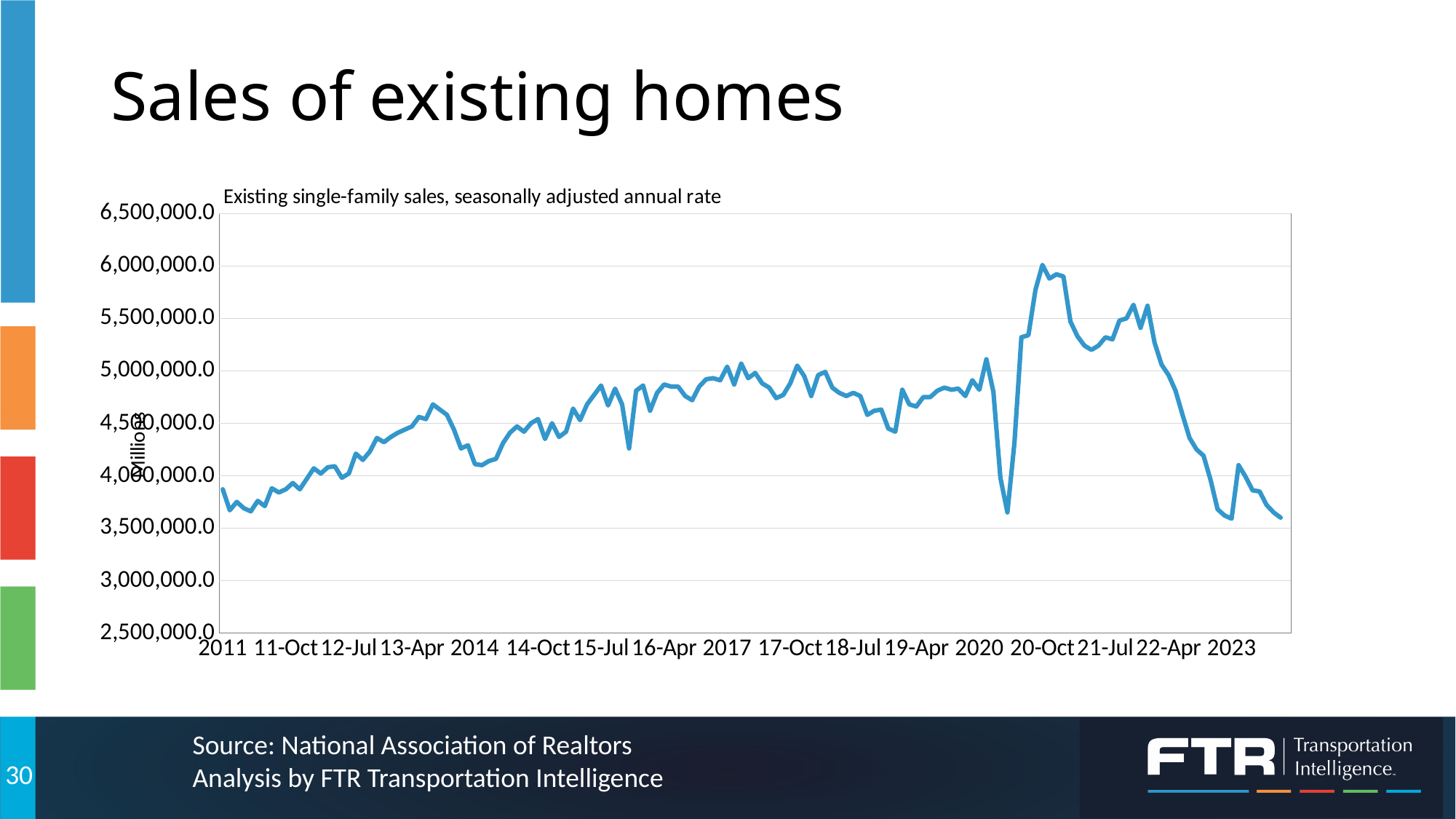
Do the values rise or fall between 2011 and 13-Apr? rise Is the value at the start of 2011 greater or less than 3,500,000? greater What is the lowest value shown on the vertical axis? 2,500,000.0 Do the values rise or fall between 22-Apr and 2023? fall Is the value around 2017 greater or less than 4,500,000? greater Is the value at the end of the series in 2023 greater or less than 4,000,000? less What is the title printed above the chart? Existing single-family sales, seasonally adjusted annual rate What kind of chart is shown on the slide? line chart